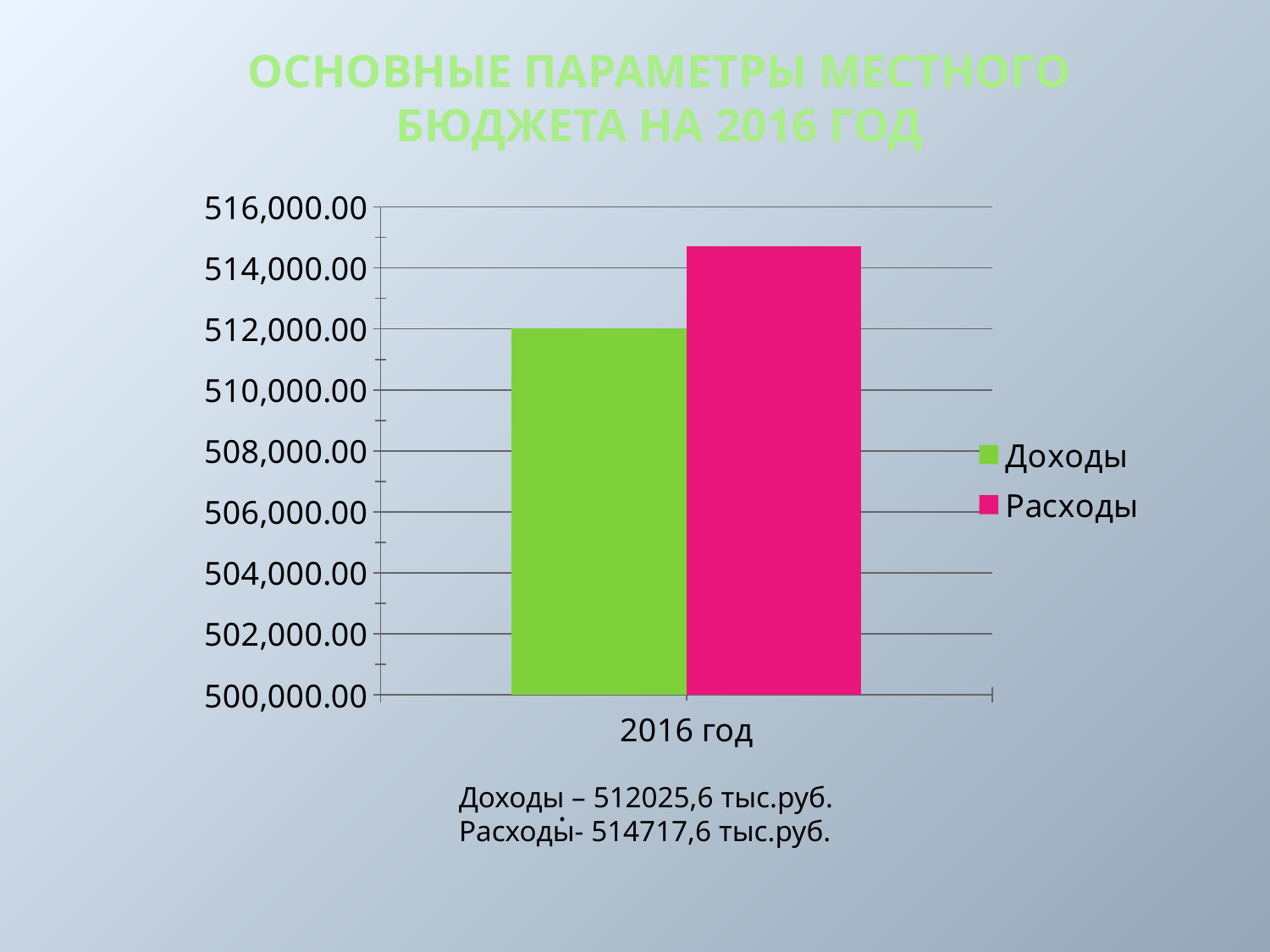
What is the value of Расходы for 2016 год? 514717,6 тыс.руб. What type of chart is shown on the slide? bar chart How many series does the legend list? 2 Is the value for Доходы greater or less than 510,000.00? greater What is the value of Доходы for 2016 год? 512025,6 тыс.руб. What is the category label on the x axis? 2016 год How many categories are shown on the x axis? 1 Is the value for Расходы greater or less than 514,000.00? greater Which series has the higher value for 2016 год, Доходы or Расходы? Расходы What is the difference between Расходы and Доходы for 2016 год? 2692,0 тыс.руб. Which series has the lowest value on the chart? Доходы What colour is the bar for Расходы? pink